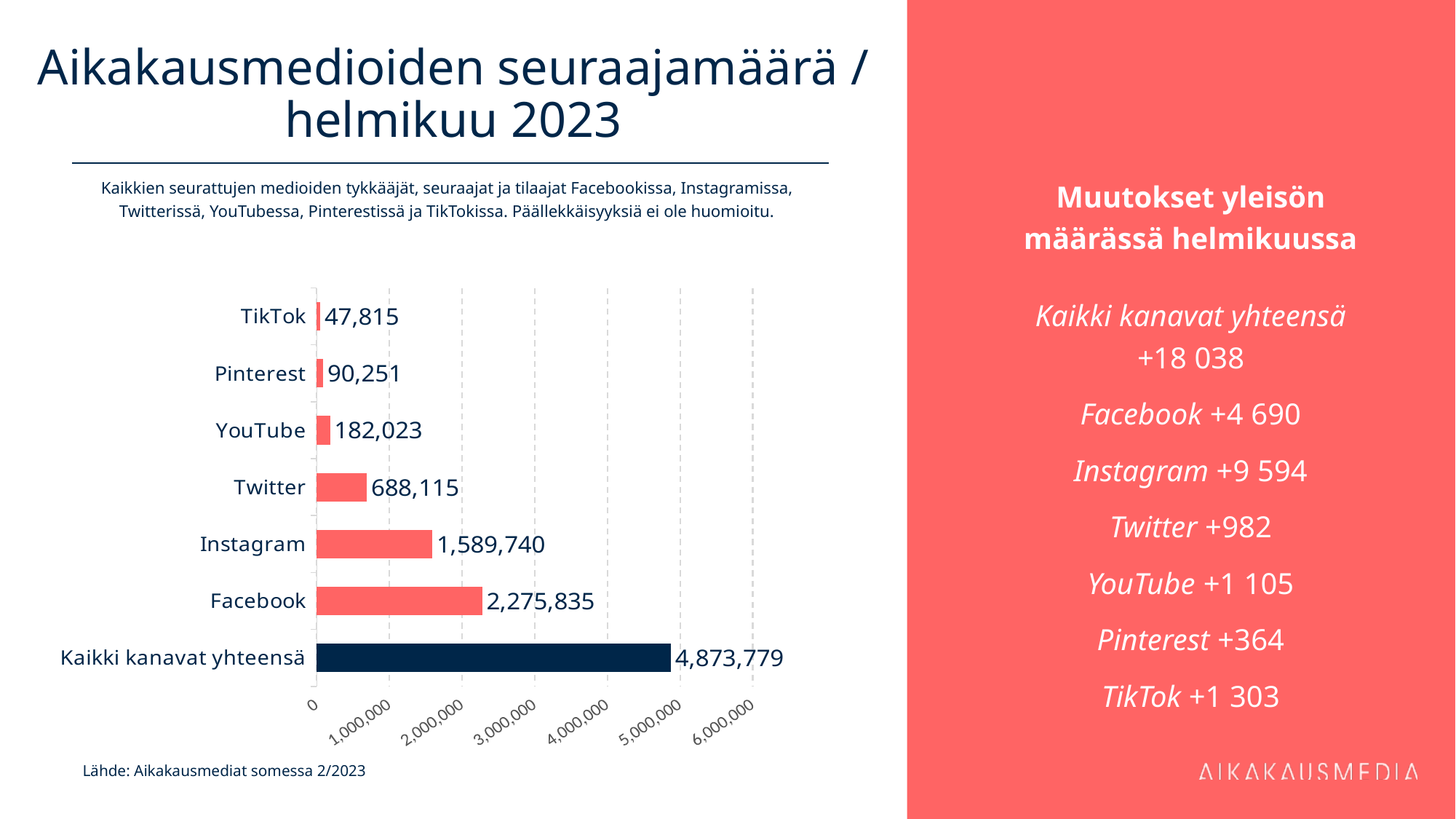
Is the value for Twitter greater or less than 1,000,000? less What is the value shown for Facebook? 2,275,835 Which category has the highest value? Kaikki kanavat yhteensä How many bars are shown in the chart? 7 What is the difference between the values for Facebook and Instagram? 686,095 What is the value shown for TikTok? 47,815 What kind of chart is shown on the slide? bar chart Which is larger, the value for Pinterest or the value for YouTube? YouTube What is the value shown for Kaikki kanavat yhteensä? 4,873,779 What is the difference between the values for Twitter and YouTube? 506,092 What is the value shown for Instagram? 1,589,740 Which category has the lowest value? TikTok